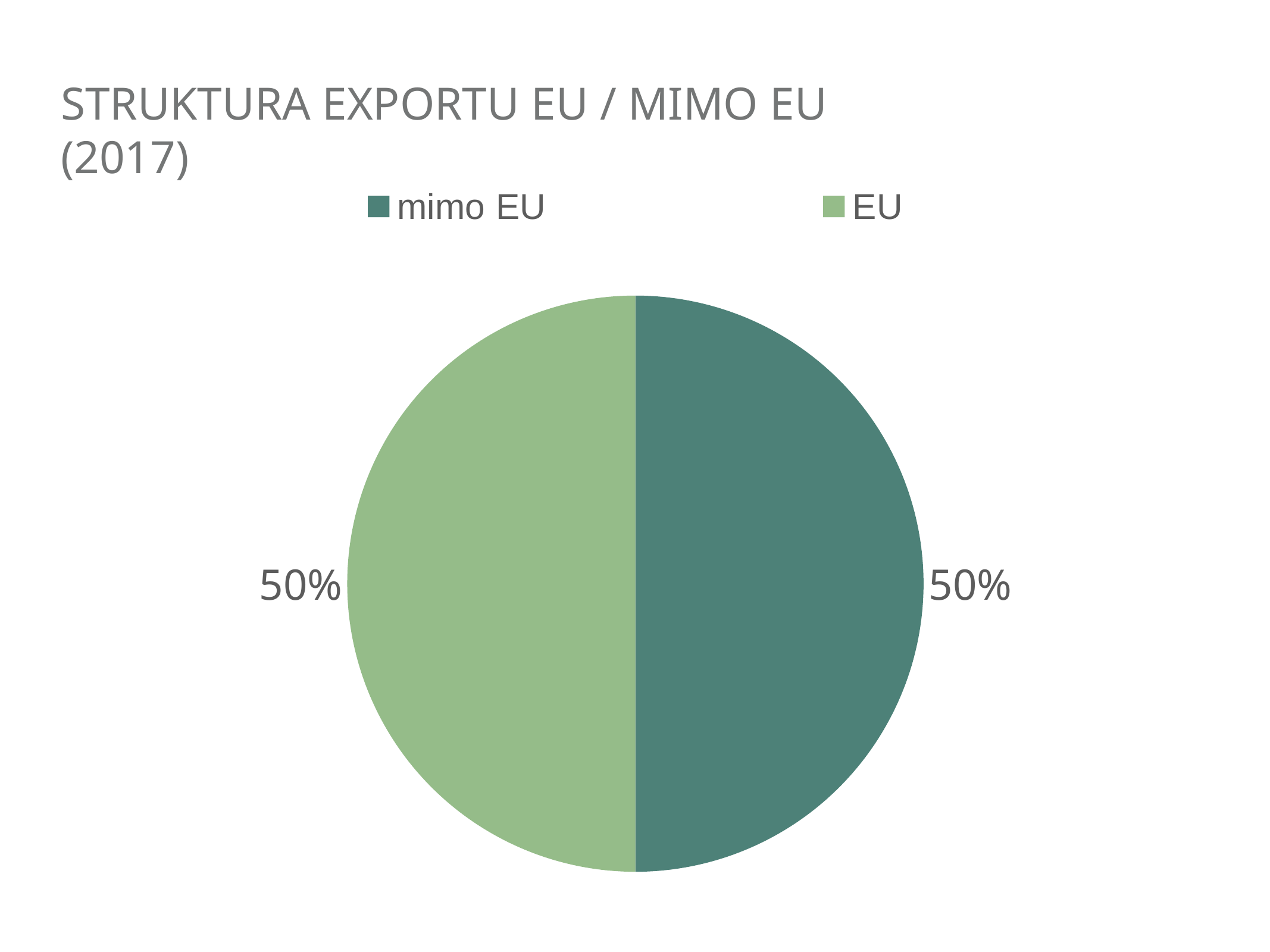
Is the value for EU greater or less than 40%? greater How many entries does the legend list? 2 What is the value shown for the EU slice? 50% What is the title of the chart? STRUKTURA EXPORTU EU / MIMO EU (2017) What kind of chart is shown on the slide? pie chart What is the difference between the EU and mimo EU shares? 0% What is the total of the two slices shown? 100% How many slices does the pie chart have? 2 What share of the pie does the EU slice represent? 50% What is the value shown for the mimo EU slice? 50% Which legend entry is shown in the darker green colour? mimo EU What share of the pie does the mimo EU slice represent? 50%